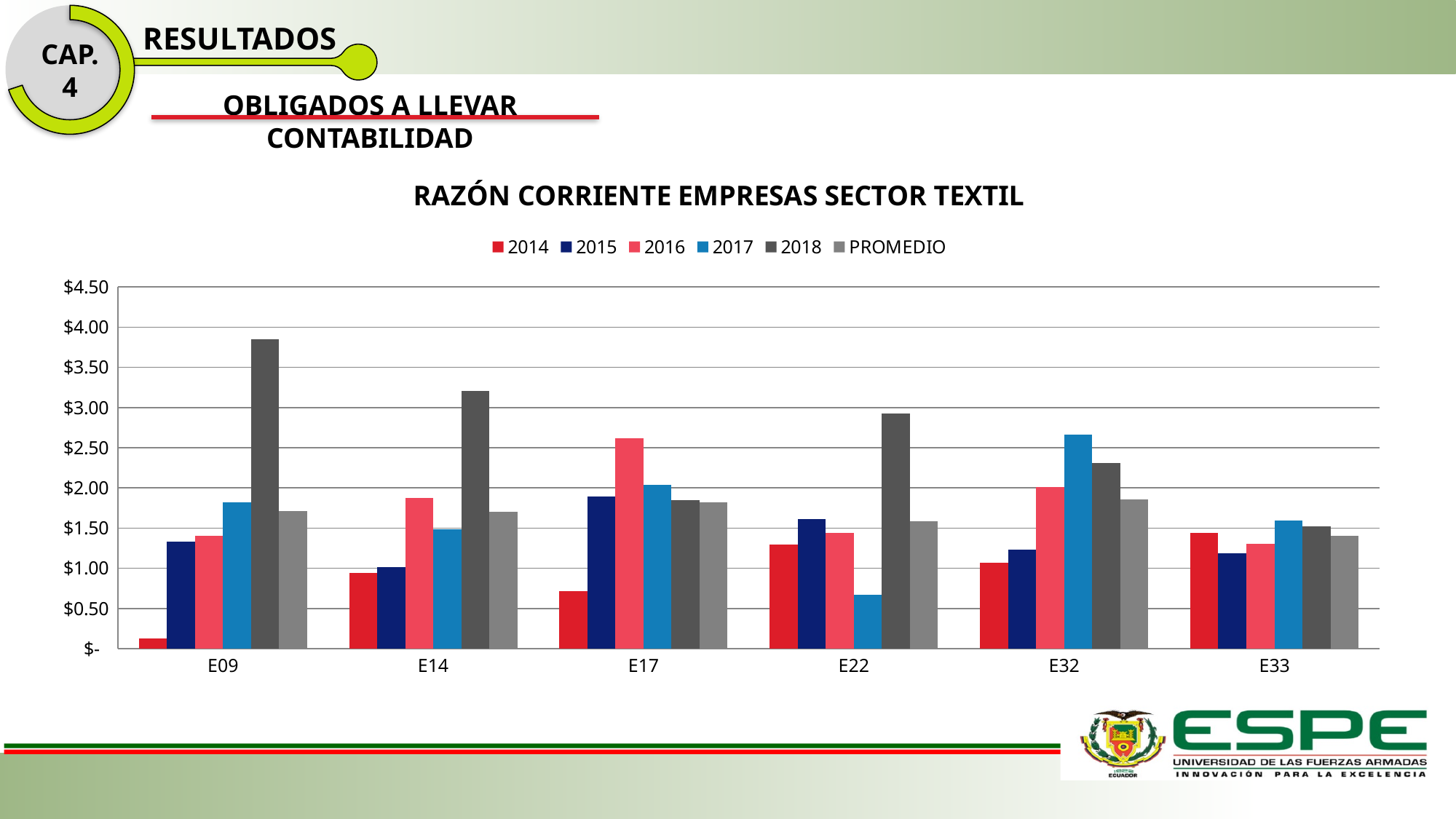
For E17, which is larger: the 2015 value or the 2016 value? 2016 Which company has the highest value for 2018? E09 Which company has the highest value for 2017? E32 For E32, which is larger: the 2017 value or the 2018 value? 2017 Is the 2018 value for E09 greater or less than $3.50? greater Is the 2017 value for E22 greater or less than $1.00? less Which company has the lowest value for 2014? E09 For E09, do the values rise or fall from 2014 to 2018? rise How many series does the legend list? 6 What kind of chart is shown on the slide? bar chart Is the 2018 value for E14 greater or less than $3.00? greater How many companies are shown on the x axis? 6